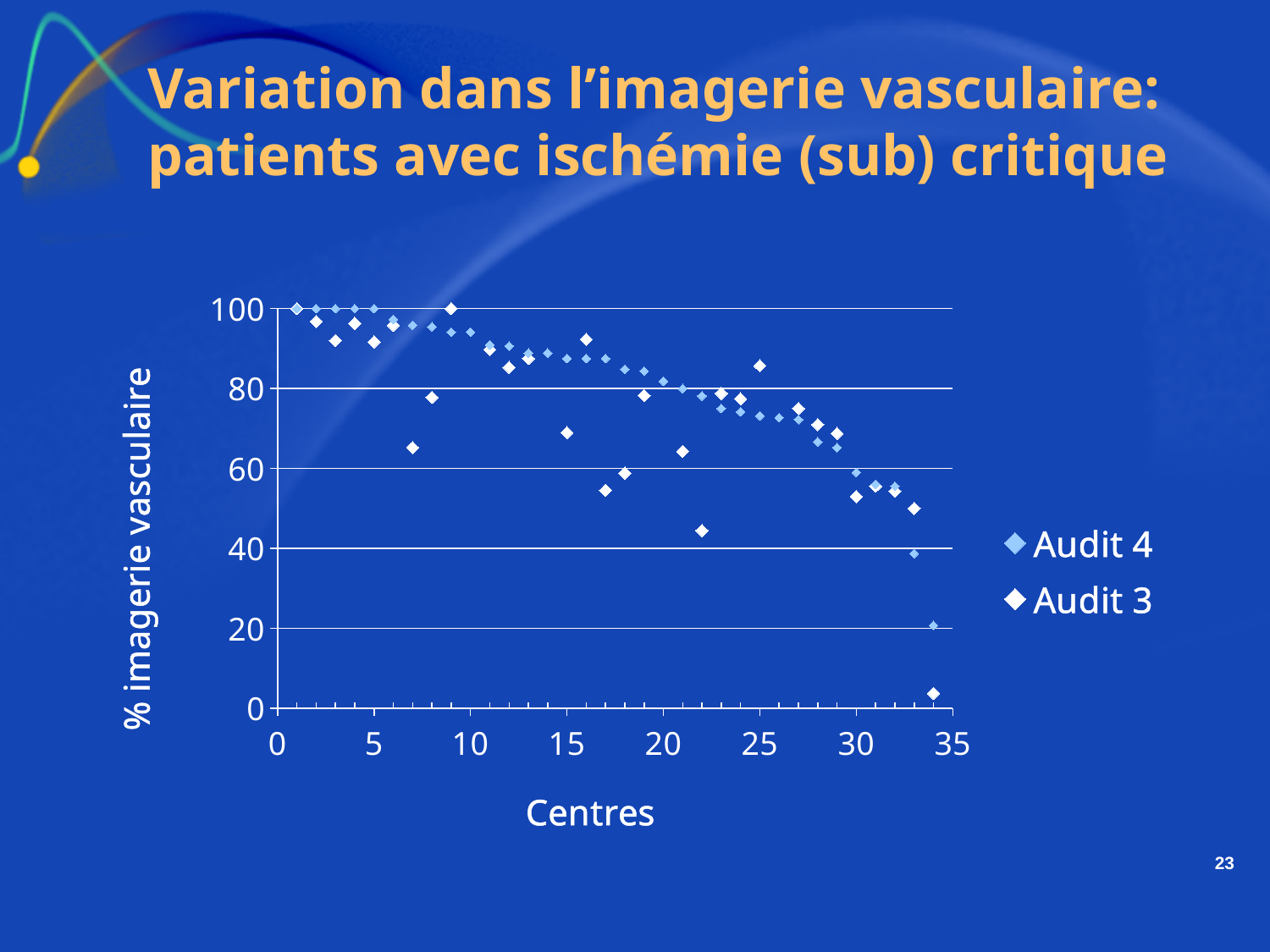
Do the Audit 4 values rise or fall as the centre number increases along the x axis? fall At centre 22, which series has the larger value, Audit 4 or Audit 3? Audit 4 Is the Audit 3 value at centre 22 greater or less than 60? less At centre 34, which series has the larger value, Audit 4 or Audit 3? Audit 4 What is the title of the y axis? % imagerie vasculaire Is the Audit 4 value at centre 34 greater or less than 40? less At which centre number is the lowest Audit 4 value plotted? 34 Is the Audit 4 value at centre 1 greater or less than 80? greater How many series does the legend list? 2 What are the two series named in the legend? Audit 4 and Audit 3 What kind of chart is shown on the slide? scatter chart